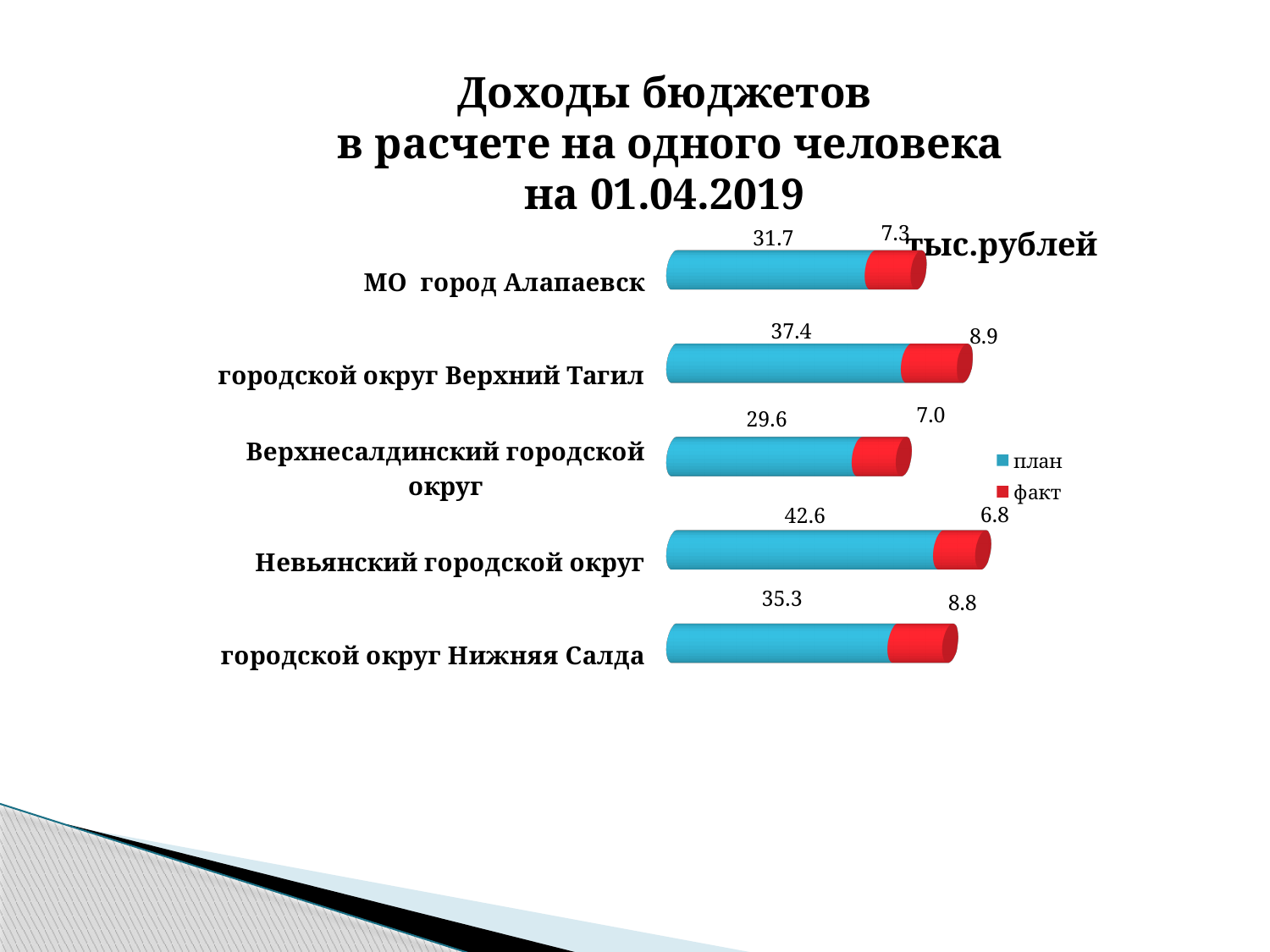
What is the total of the stacked bar for городской округ Верхний Тагил? 46.3 Which category has the highest план value? Невьянский городской округ What is the план value for Невьянский городской округ? 42.6 How many series does the legend list? 2 What kind of chart is shown on the slide? Stacked bar chart Which is larger: the факт value for городской округ Нижняя Салда or the факт value for МО город Алапаевск? городской округ Нижняя Салда Which category has the lowest план value? Верхнесалдинский городской округ How many categories are shown in the chart? 5 Which category has the lowest факт value? Невьянский городской округ What is the план value for МО город Алапаевск? 31.7 What is the факт value for городской округ Верхний Тагил? 8.9 What is the difference between the план values for Невьянский городской округ and Верхнесалдинский городской округ? 13.0